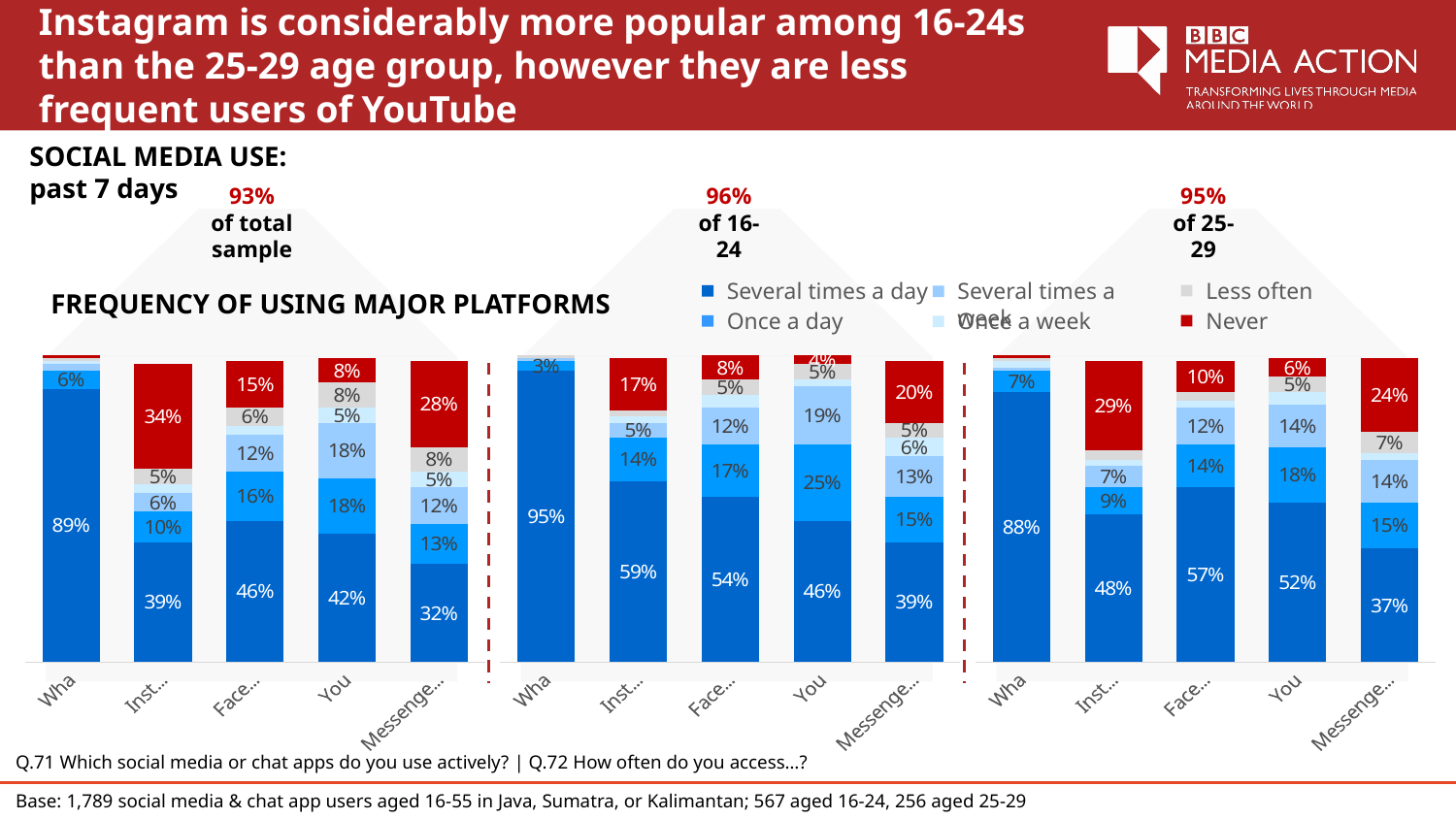
In the right chart (25-29), what is the 'Never' value for the Messenge... bar? 24% In the middle chart (16-24), what is the 'Several times a day' value for the Inst... bar? 59% What type of chart is used to show frequency of using major platforms? Stacked bar chart In the middle chart (16-24), which platform bar has the highest 'Several times a day' value? Wha... In the right chart (25-29), which platform bar has the lowest 'Several times a day' value? Messenge... Is the 'Several times a day' value for You... larger in the middle chart (16-24) or in the right chart (25-29)? Right chart (25-29) How many platform bars are shown in each of the three charts? 5 What colour represents 'Never' in the legend? Red In the left chart (total sample), what percentage of the first bar (Wha...) is 'Several times a day'? 89% In the left chart (total sample), what is the 'Never' value for the Inst... bar? 34% How many series does the legend list? 6 What is the difference between the 'Several times a day' value for Inst... in the middle chart (16-24) and in the right chart (25-29)? 11%